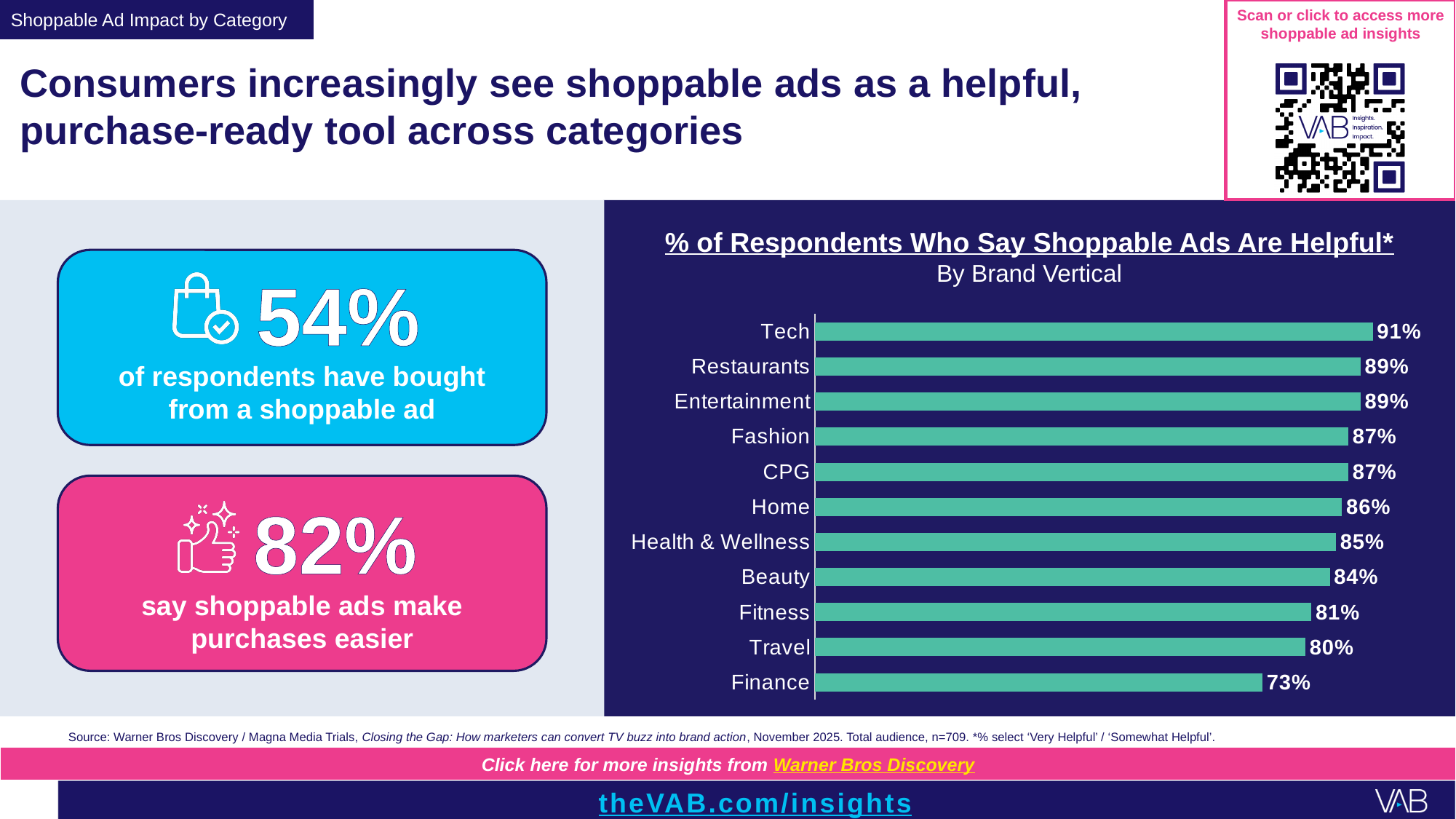
What percentage is shown for Health & Wellness? 85% Which brand vertical has the lowest percentage in the chart? Finance Which brand vertical has the highest percentage of respondents saying shoppable ads are helpful? Tech What is the subtitle shown beneath the chart title? By Brand Vertical Which has a higher value, Fitness or Home? Home What is the difference in percentage points between Tech and Finance? 18 What type of chart is used to show the % of respondents who say shoppable ads are helpful? Bar chart What is the difference in percentage points between Beauty and Travel? 4 How many brand verticals are shown in the chart? 11 What percentage of respondents say shoppable ads are helpful for the Tech vertical? 91% Do the values rise or fall going from the top bar (Tech) to the bottom bar (Finance)? Fall What is the value shown for Finance in the chart? 73%